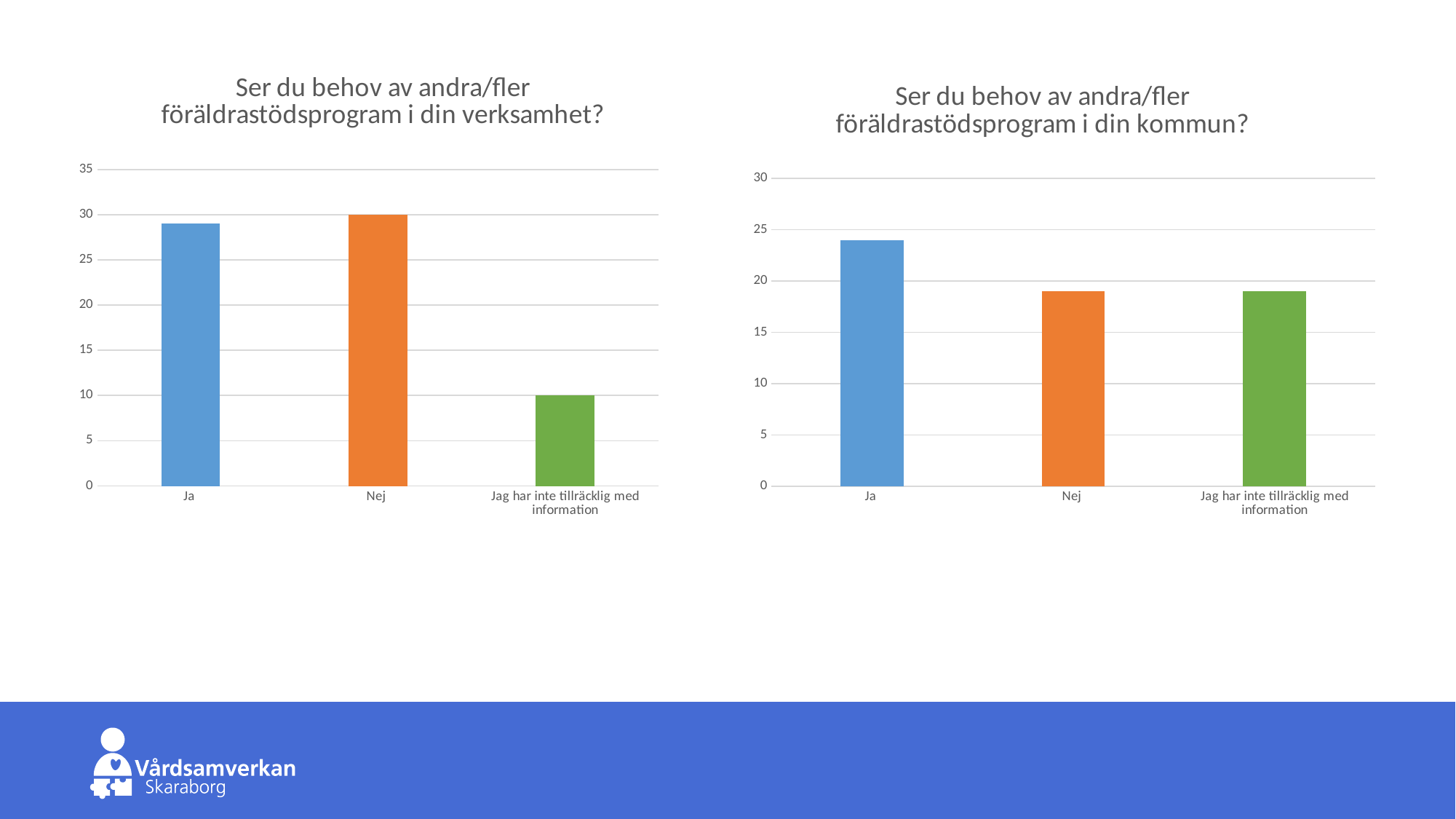
On the right chart ("...i din kommun?"), is the value for Ja larger than the value for Nej? Yes On the right chart ("...i din kommun?"), is the value for Ja greater or less than 20? greater How many categories are shown on the right chart ("...i din kommun?")? 3 On the left chart ("...i din verksamhet?"), what is the value for "Jag har inte tillräcklig med information"? 10 On the left chart ("...i din verksamhet?"), which category has the lowest value? Jag har inte tillräcklig med information On the left chart ("Ser du behov av andra/fler föräldrastödsprogram i din verksamhet?"), what is the value for Nej? 30 On the left chart ("...i din verksamhet?"), is the value for Ja greater or less than 25? greater What is the title of the right chart? Ser du behov av andra/fler föräldrastödsprogram i din kommun? What kind of chart is the left chart ("...i din verksamhet?")? Bar chart On the left chart ("...i din verksamhet?"), what is the difference between the values for Nej and "Jag har inte tillräcklig med information"? 20 On the right chart ("Ser du behov av andra/fler föräldrastödsprogram i din kommun?"), which category has the highest value? Ja On the right chart ("...i din kommun?"), is the value for Nej greater or less than 20? less